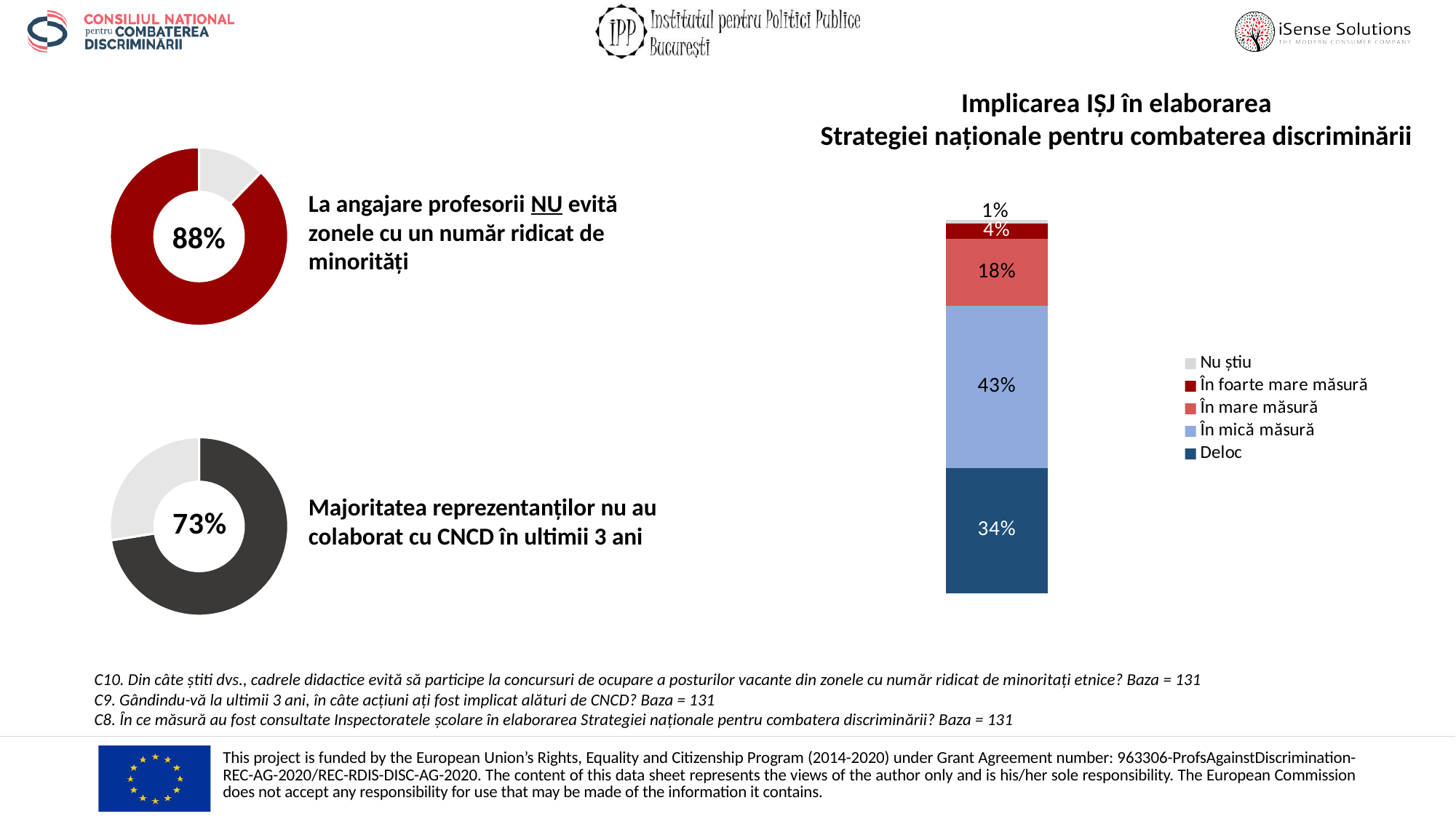
In the stacked bar chart titled 'Implicarea IȘJ în elaborarea Strategiei naționale pentru combaterea discriminării', which category has the largest share? În mică măsură In the stacked bar chart titled 'Implicarea IȘJ în elaborarea Strategiei naționale pentru combaterea discriminării', which is larger: 'În mare măsură' or 'Deloc'? Deloc In the stacked bar chart titled 'Implicarea IȘJ în elaborarea Strategiei naționale pentru combaterea discriminării', what is the value for 'Deloc'? 34% What value is shown in the centre of the top-left donut chart (red)? 88% What is the total of the stacked bar in the chart titled 'Implicarea IȘJ în elaborarea Strategiei naționale pentru combaterea discriminării'? 100% In the stacked bar chart titled 'Implicarea IȘJ în elaborarea Strategiei naționale pentru combaterea discriminării', which category has the smallest share? Nu știu How many entries does the legend of the stacked bar chart titled 'Implicarea IȘJ în elaborarea Strategiei naționale pentru combaterea discriminării' list? 5 What value is shown in the centre of the bottom-left donut chart (dark grey)? 73% In the stacked bar chart titled 'Implicarea IȘJ în elaborarea Strategiei naționale pentru combaterea discriminării', what is the value for 'În mare măsură'? 18% In the stacked bar chart titled 'Implicarea IȘJ în elaborarea Strategiei naționale pentru combaterea discriminării', what is the difference between 'În mică măsură' and 'Deloc'? 9% In the stacked bar chart titled 'Implicarea IȘJ în elaborarea Strategiei naționale pentru combaterea discriminării', what is the value for 'În mică măsură'? 43% In the stacked bar chart titled 'Implicarea IȘJ în elaborarea Strategiei naționale pentru combaterea discriminării', what is the value for 'În foarte mare măsură'? 4%